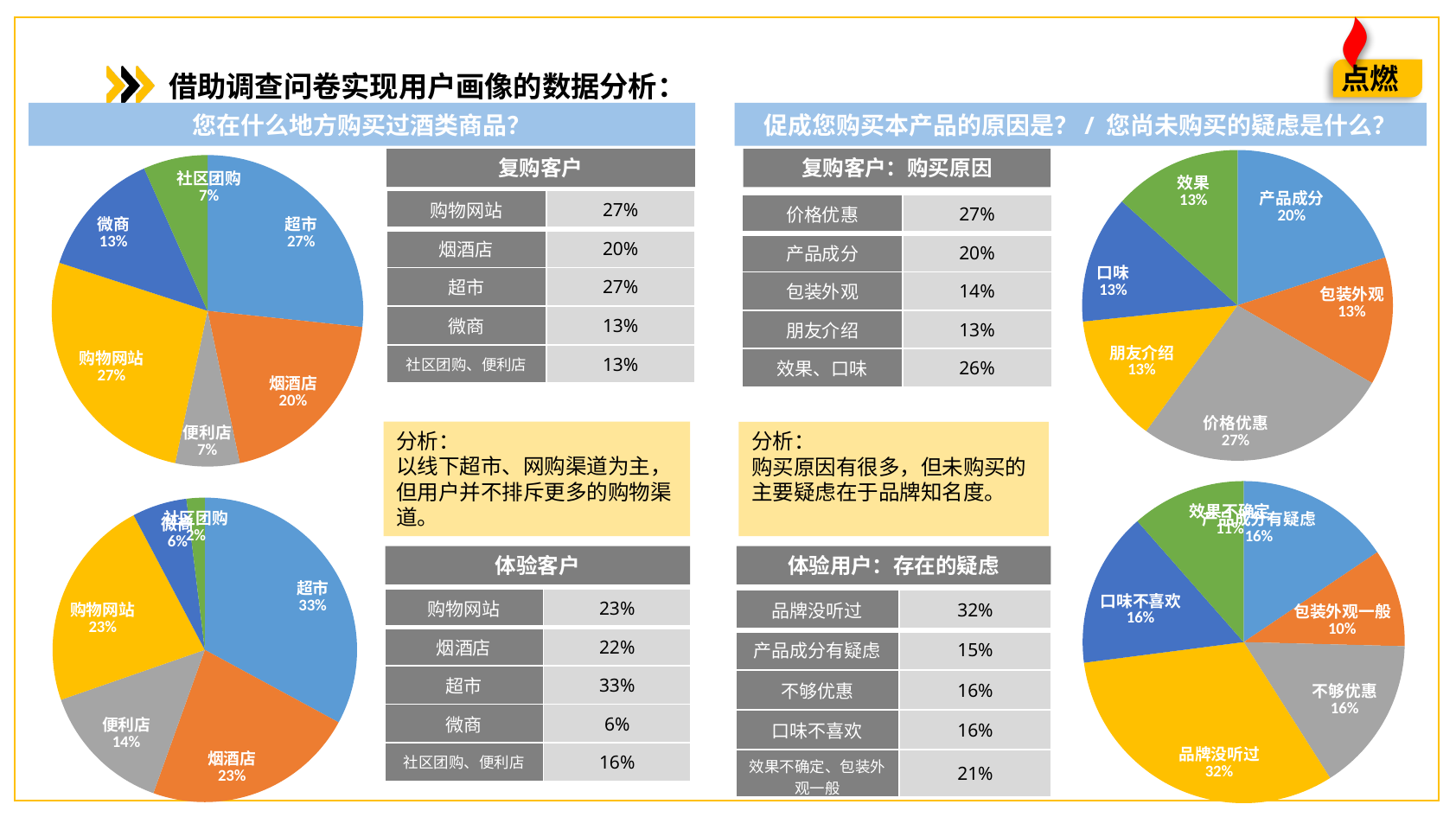
What type of chart is the top-left chart? Pie chart In the bottom-right pie chart, which category has the largest slice? 品牌没听过 In the bottom-left pie chart, which category has the smallest slice? 社区团购 In the bottom-left pie chart, which category has the largest slice? 超市 In the top-right pie chart, which is larger, 产品成分 or 包装外观? 产品成分 How many pie charts are on the slide? 4 In the top-left pie chart, what percentage is shown for 超市? 27% In the bottom-right pie chart, what percentage is shown for 包装外观一般? 10% In the top-right pie chart, what percentage is shown for 价格优惠? 27% How many slices does the bottom-right pie chart have? 6 In the top-left pie chart, what percentage is shown for 微商? 13% In the bottom-left pie chart, what is the difference between the 超市 slice and the 便利店 slice? 19%